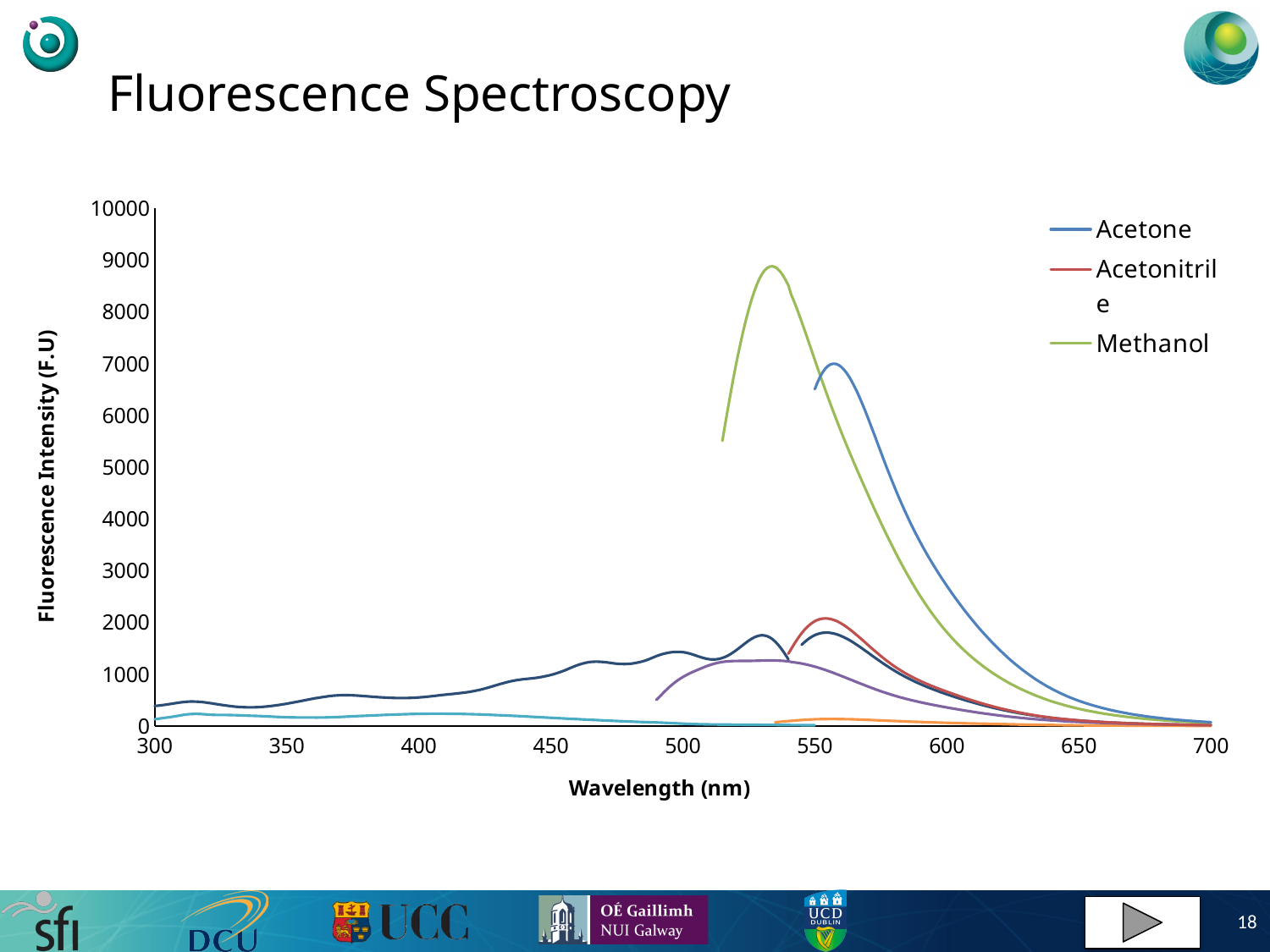
Which has a higher peak fluorescence intensity, Methanol or Acetone? Methanol Is the peak value for Acetone greater or less than 6000? greater Which has a higher peak fluorescence intensity, Acetone or Acetonitrile? Acetone Is the peak value for Methanol greater or less than 8000? greater What kind of chart is shown on the slide? line chart What is the title of the slide containing the chart? Fluorescence Spectroscopy How many series does the legend list? 3 Is the peak value for Acetone greater or less than 8000? less What is the label of the x axis? Wavelength (nm) Which legend series reaches the highest peak fluorescence intensity? Methanol Which of the three legend series has the lowest peak fluorescence intensity? Acetonitrile